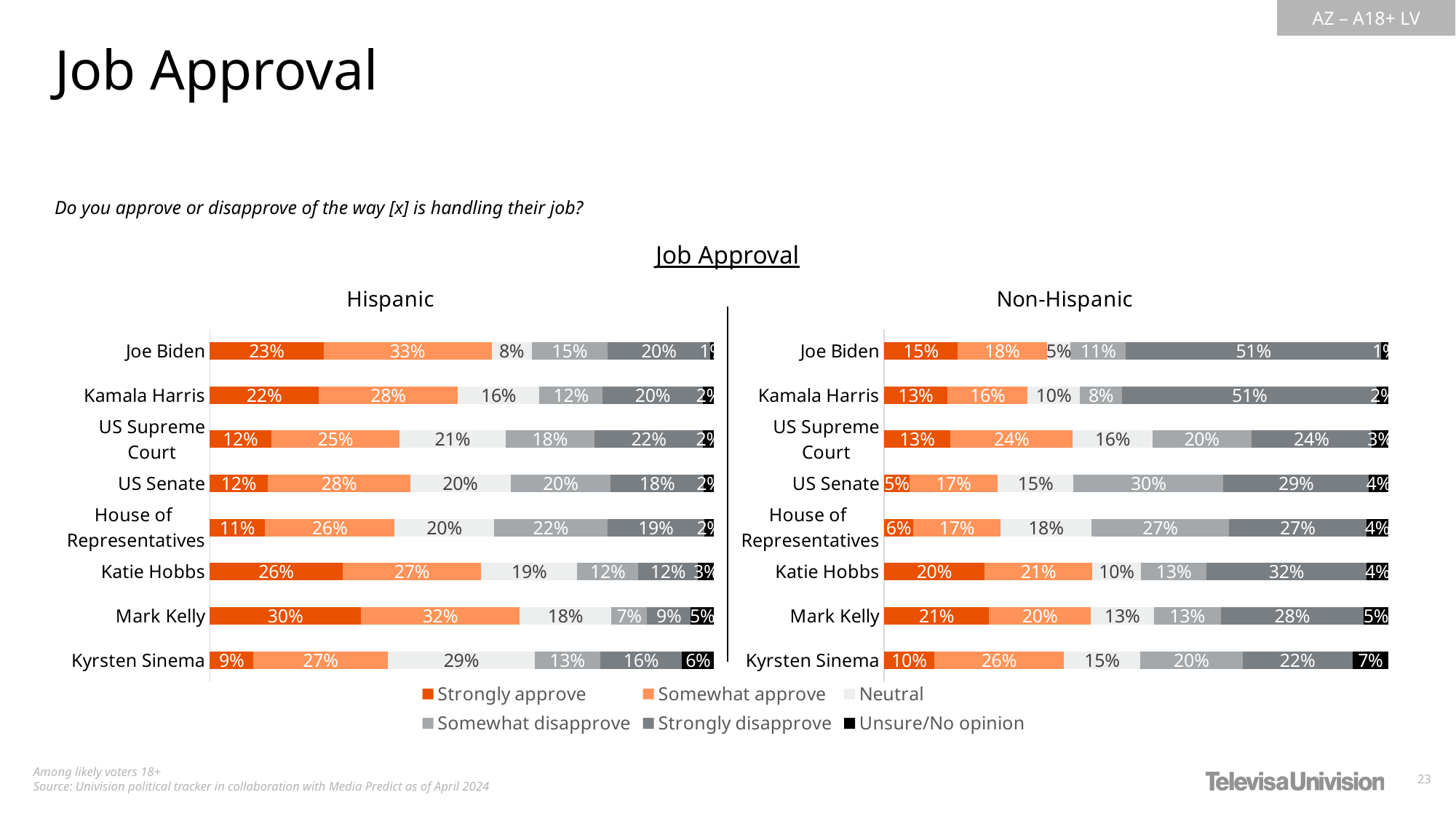
In the Hispanic chart, what percentage are neutral on Kyrsten Sinema? 29% Which is larger: the strongly disapprove percentage for Katie Hobbs in the Hispanic chart or in the Non-Hispanic chart? Non-Hispanic What is the title shown above the two charts? Job Approval How many people or institutions are listed in the Hispanic chart? 8 How many series does the legend list? 6 What type of chart is used for the Hispanic and Non-Hispanic panels? Stacked bar chart In the Hispanic chart, what percentage strongly approve of Joe Biden? 23% In the Hispanic chart, what is the difference between the somewhat approve percentages for Joe Biden and Kyrsten Sinema? 6% In the Non-Hispanic chart, what percentage somewhat disapprove of the US Senate? 30% In the Hispanic chart, which person or institution has the highest strongly approve percentage? Mark Kelly In the Non-Hispanic chart, which person or institution has the lowest strongly approve percentage? US Senate In the Non-Hispanic chart, what percentage strongly disapprove of Kamala Harris? 51%